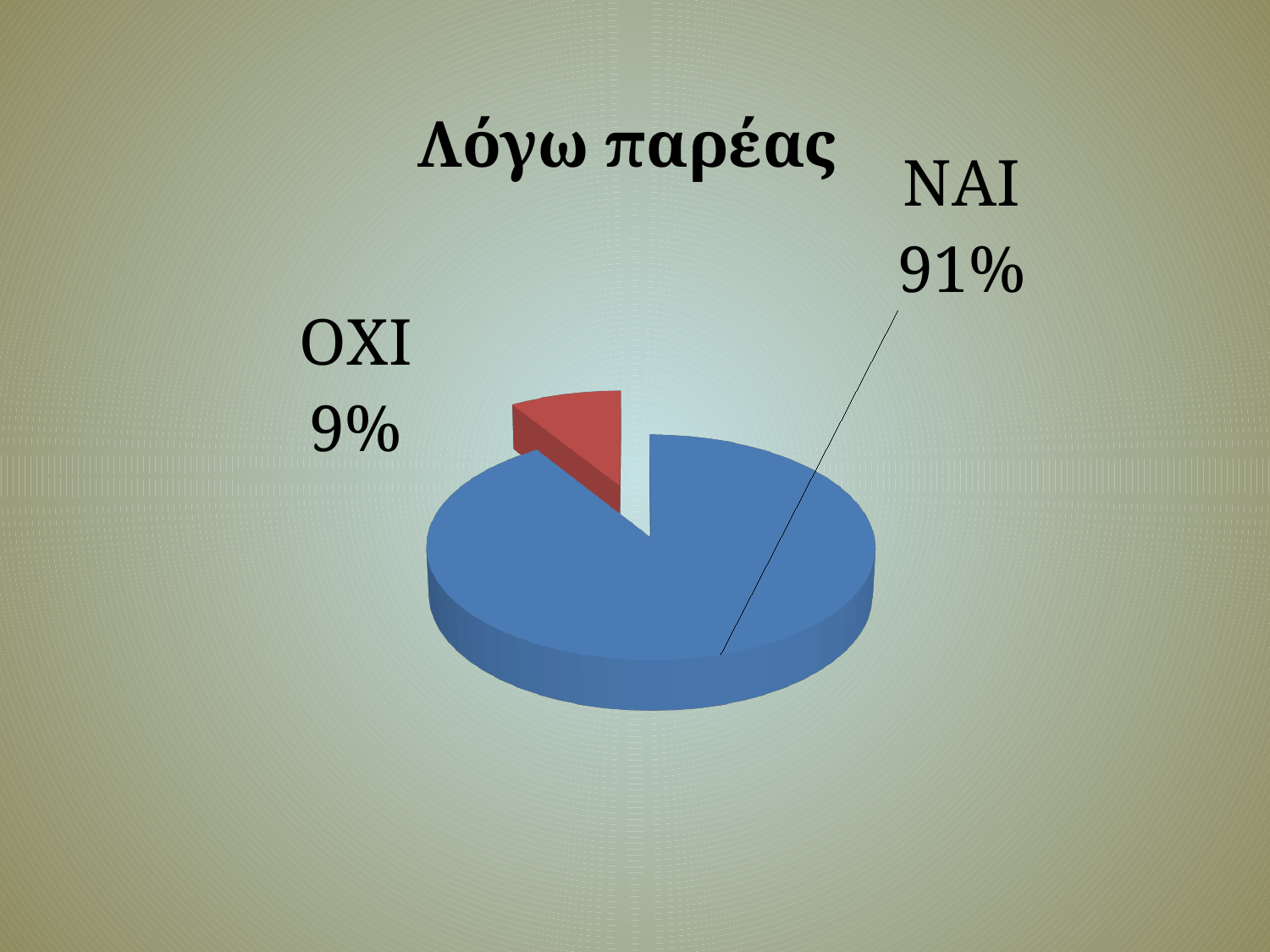
Which slice is the smallest? ΟΧΙ How many slices does the pie chart have? 2 Which is larger, ΝΑΙ or ΟΧΙ? ΝΑΙ What share of the pie does ΝΑΙ represent? 91% What colour is the ΟΧΙ slice? red Which slice is the largest? ΝΑΙ What share of the pie does ΟΧΙ represent? 9% What kind of chart is shown on the slide? pie chart What is the title of the chart? Λόγω παρέας What is the difference in percentage points between ΝΑΙ and ΟΧΙ? 82